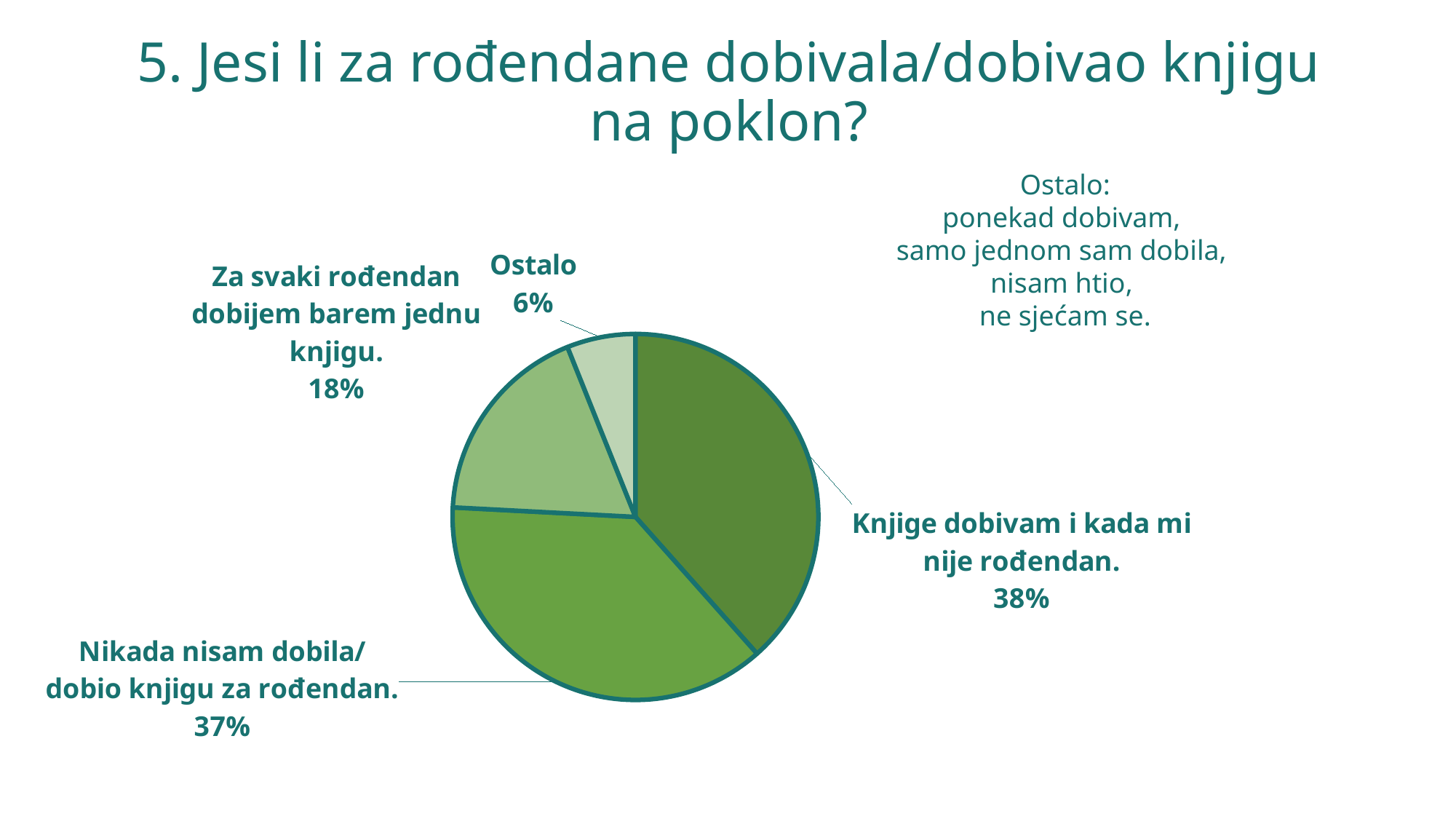
Which is larger: the slice for "Za svaki rođendan dobijem barem jednu knjigu." or the slice for "Ostalo"? Za svaki rođendan dobijem barem jednu knjigu. What is the title of the slide? 5. Jesi li za rođendane dobivala/dobivao knjigu na poklon? Which category has the smallest slice of the pie? Ostalo Which category has the largest slice of the pie? Knjige dobivam i kada mi nije rođendan. What share of the pie does "Knjige dobivam i kada mi nije rođendan." have? 38% How many percentage points larger is "Knjige dobivam i kada mi nije rođendan." than "Ostalo"? 32 What is the difference in percentage points between "Nikada nisam dobila/dobio knjigu za rođendan." and "Za svaki rođendan dobijem barem jednu knjigu."? 19 What percentage is shown for the "Ostalo" slice? 6% How many slices does the pie chart have? 4 What percentage is shown for "Nikada nisam dobila/dobio knjigu za rođendan."? 37% What percentage is shown for "Za svaki rođendan dobijem barem jednu knjigu."? 18% What kind of chart is shown on the slide? Pie chart